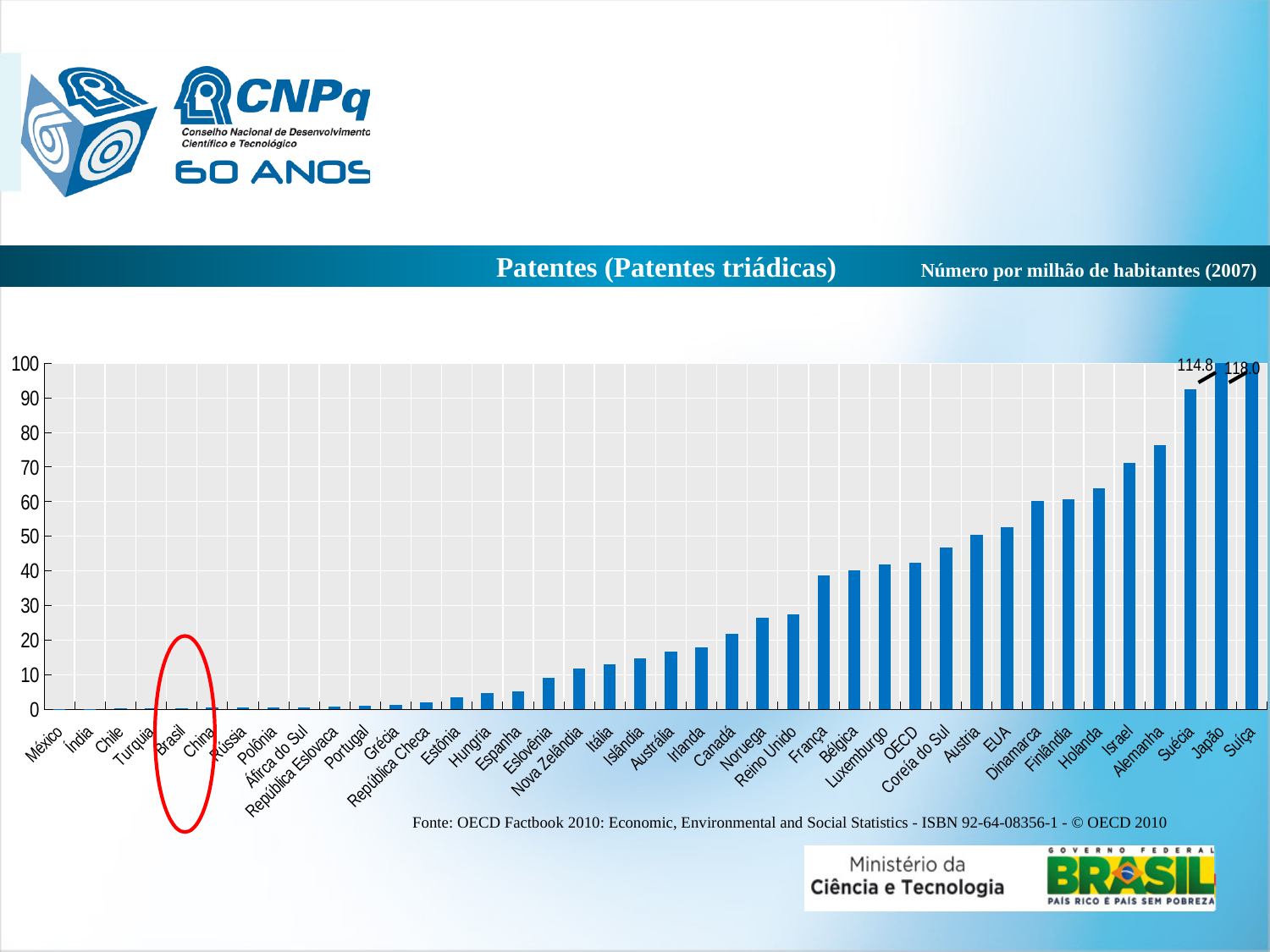
Is the value for Coreia do Sul greater or less than 50? less Do the values generally rise or fall from left to right along the x axis? rise Which has a larger value, Alemanha or Israel? Alemanha What is the difference between the values for Suíça and Japão? 3.2 Which country has the highest number of triadic patents per million inhabitants? Suíça What kind of chart is shown on the slide? bar chart Which country is circled in red on the chart? Brasil What is the value shown for Suíça? 118.0 What is the value shown for Japão? 114.8 Which has a larger value, Japão or Suécia? Japão Is the value for Reino Unido greater or less than 30? less Is the value for Alemanha greater or less than 70? greater